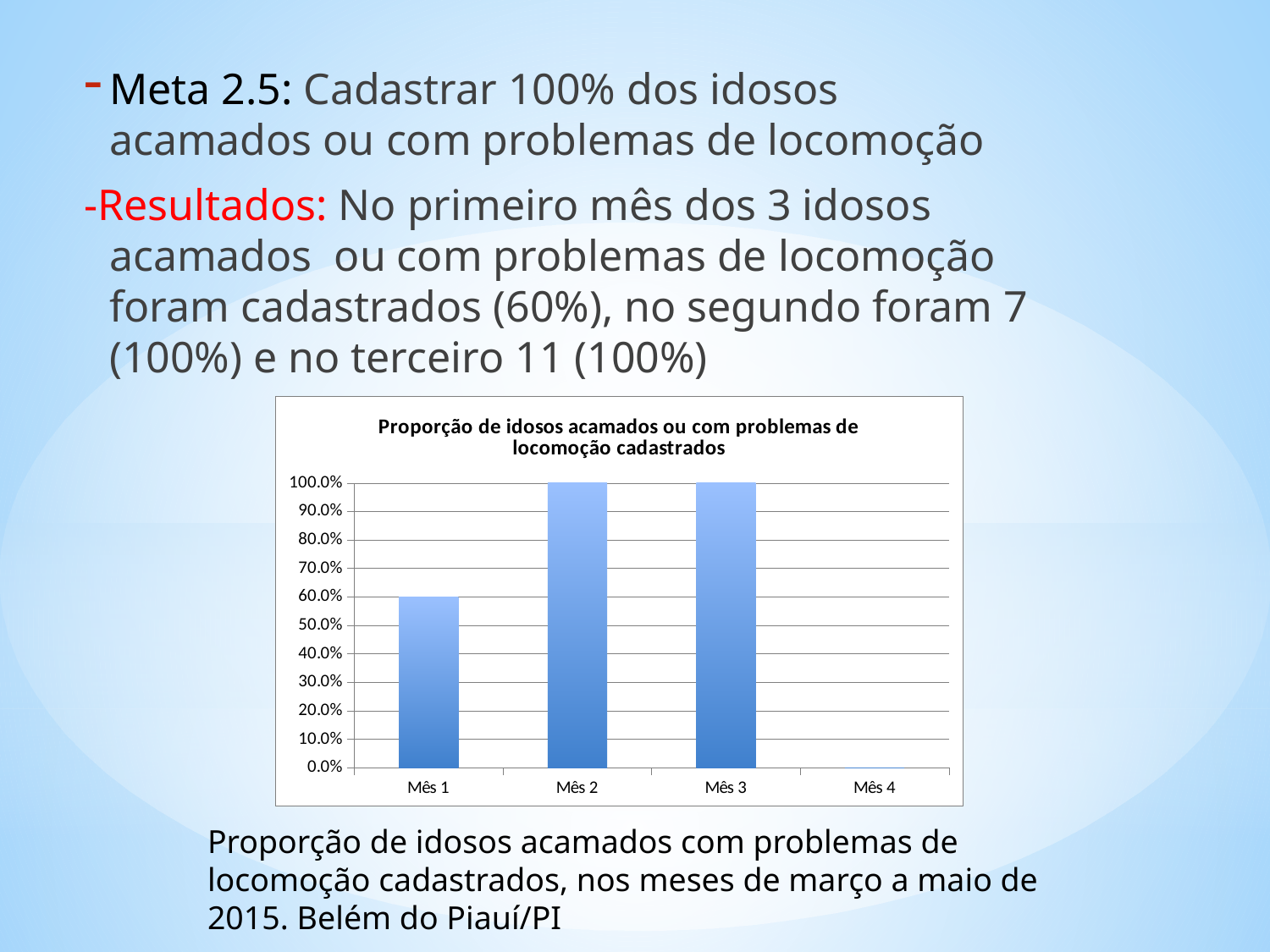
How many categories are shown on the x axis of the chart? 4 What is the difference between the values for Mês 2 and Mês 1? 40.0% What is the value for Mês 2 in the chart? 100.0% Is the value for Mês 1 greater or less than 50.0%? greater Is the value for Mês 3 greater or less than 90.0%? greater What is the highest value shown on the y axis of the chart? 100.0% What type of chart is shown on the slide? bar chart What is the title of the chart? Proporção de idosos acamados ou com problemas de locomoção cadastrados Which is larger in the chart, the value for Mês 1 or the value for Mês 2? Mês 2 What is the value for Mês 1 in the chart? 60.0% Does the value rise or fall from Mês 1 to Mês 2? rise What is the value for Mês 3 in the chart? 100.0%